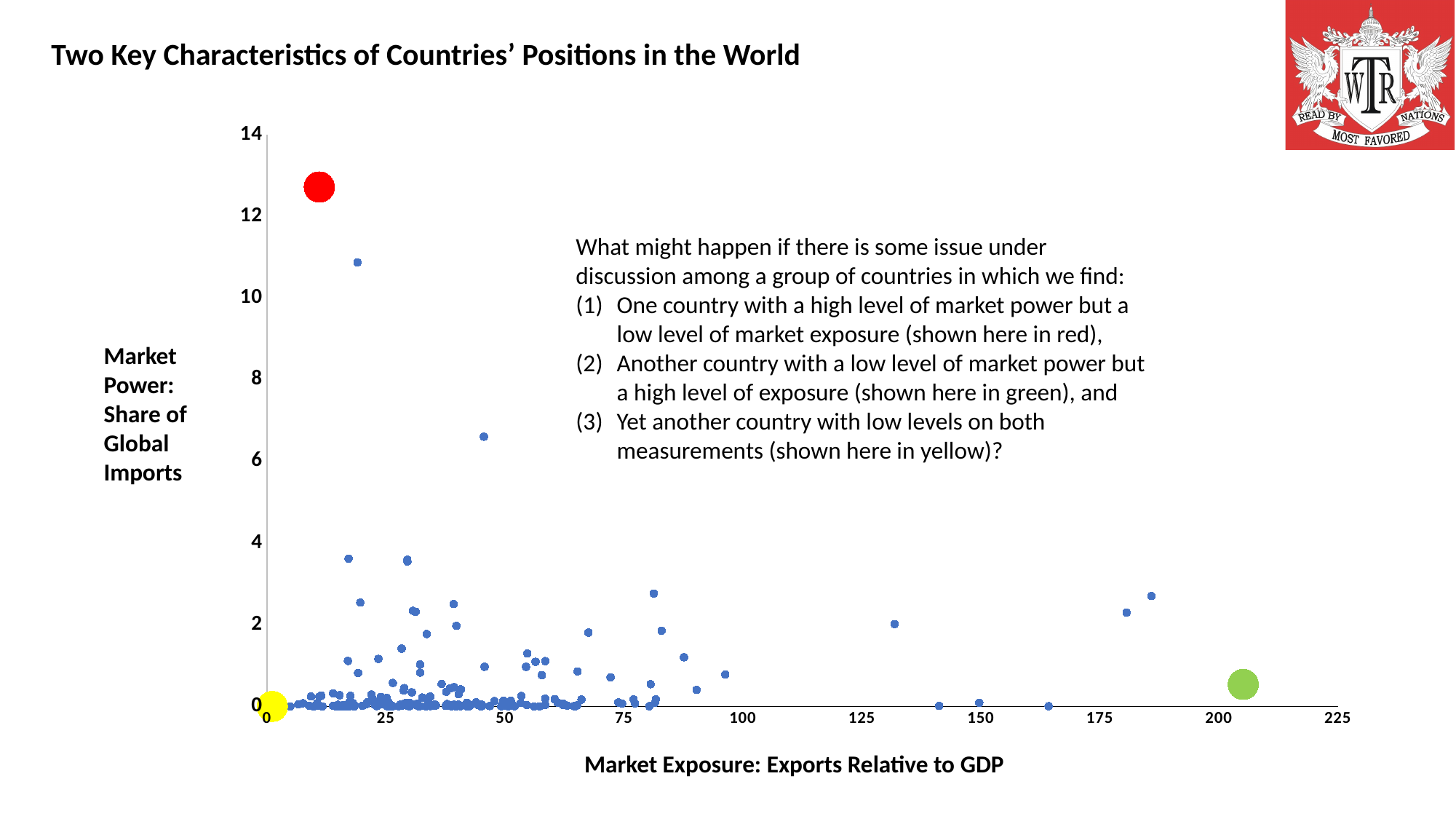
What is the title of the horizontal axis of the chart? Market Exposure: Exports Relative to GDP Which of the three highlighted points (red, green, yellow) has the highest Market Exposure value? green Is the Market Power value of the red point greater or less than 12? greater What kind of chart is shown on the slide? scatter plot Is the Market Exposure value of the red point greater or less than 25? less What is the title of the vertical axis of the chart? Market Power: Share of Global Imports Is the Market Exposure value of the green point greater or less than 200? greater Which of the three highlighted points (red, green, yellow) has the highest Market Power value? red What is the highest value shown on the vertical axis of the chart? 14 Which has a higher Market Power value, the red point or the green point? red